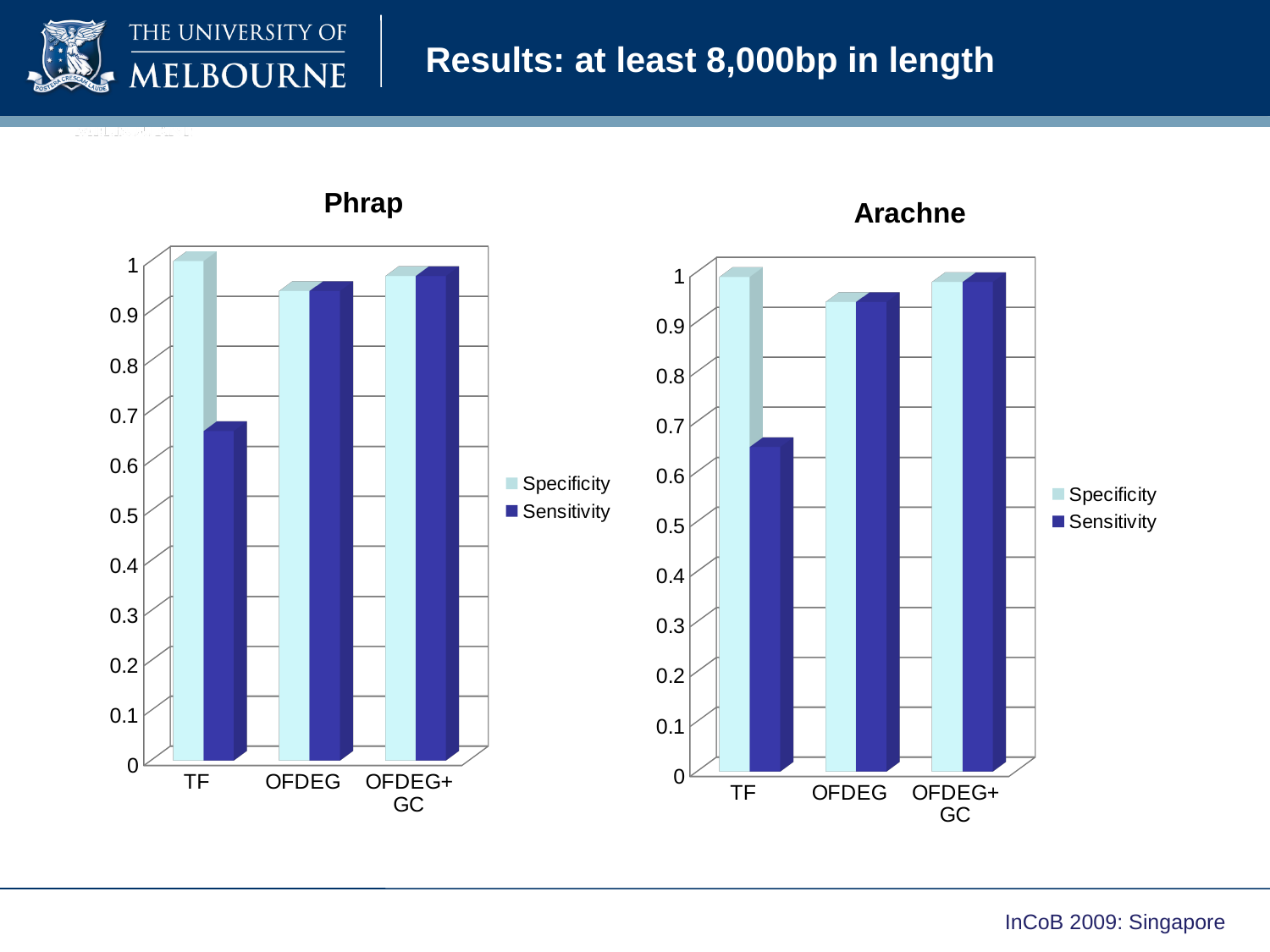
On the Arachne chart, is the Sensitivity value for TF greater or less than 0.7? less On the Arachne chart, what are the two entries in the legend? Specificity and Sensitivity On the Arachne chart, which category has the lowest Sensitivity? TF On the Phrap chart, how many series does the legend list? 2 On the Phrap chart, is the Specificity value for OFDEG greater or less than 0.9? greater On the Phrap chart, is the Sensitivity value for TF greater or less than 0.7? less On the Phrap chart, what kind of chart is shown? Bar chart On the Phrap chart, how many categories are shown on the x axis? 3 On the Arachne chart, how many categories are shown on the x axis? 3 On the Phrap chart, for TF, which is larger: Specificity or Sensitivity? Specificity On the Arachne chart, for TF, which is larger: Specificity or Sensitivity? Specificity On the Phrap chart, which category has the lowest Sensitivity? TF